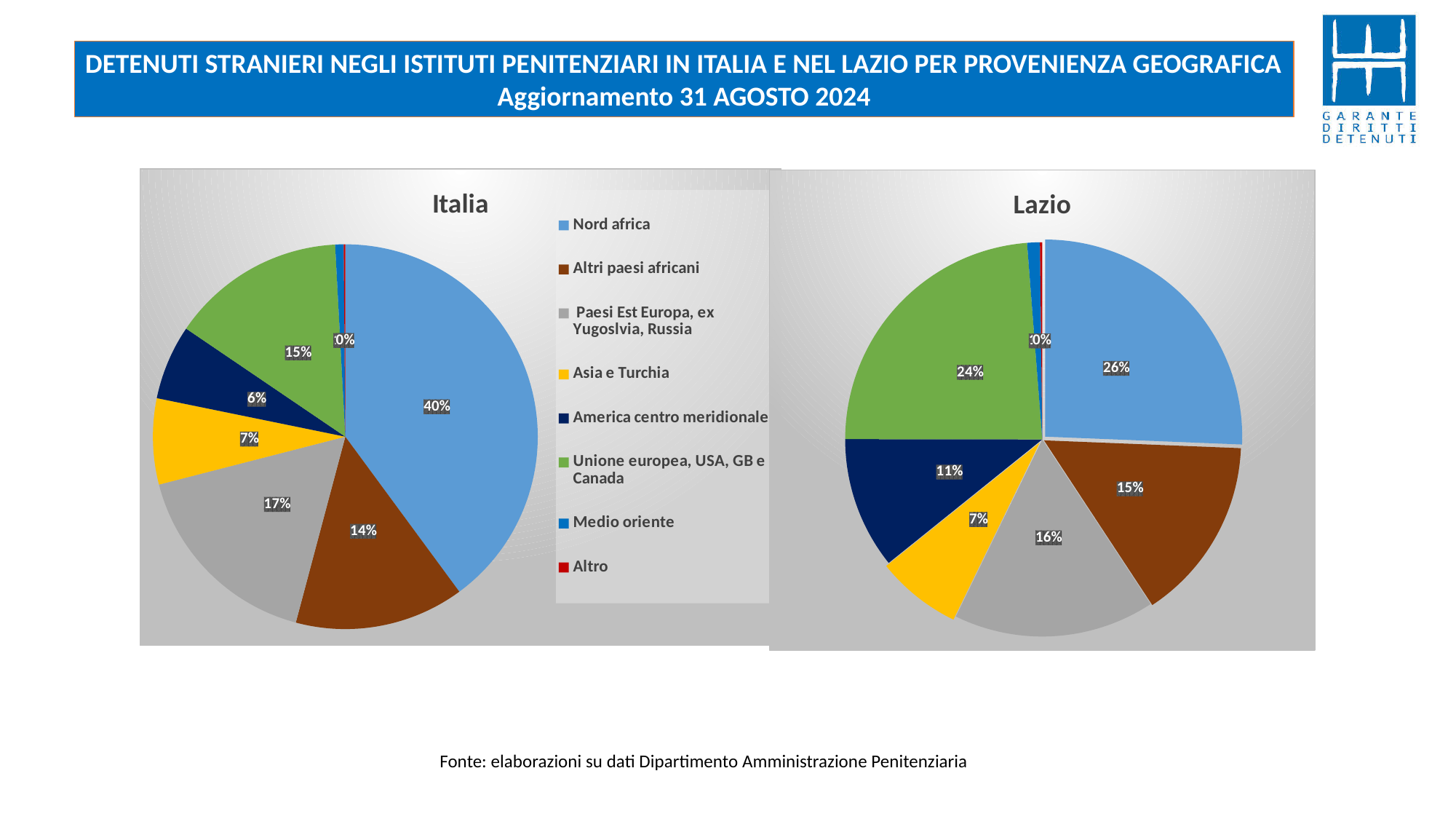
In the 'Italia' chart, what share is shown for Nord africa? 40% In the 'Lazio' chart, what share is shown for America centro meridionale? 11% What is the difference between the Nord africa share in the 'Italia' chart and in the 'Lazio' chart? 14 percentage points In the 'Lazio' chart, what share is shown for Unione europea, USA, GB e Canada? 24% Which colour represents Asia e Turchia in the legend? yellow What kind of chart is the 'Italia' chart? pie chart In the 'Italia' chart, what share is shown for Paesi Est Europa, ex Yugoslvia, Russia? 17% In the 'Italia' chart, which category has the largest slice? Nord africa In the 'Lazio' chart, what share is shown for Nord africa? 26% In the 'Italia' chart, what share is shown for America centro meridionale? 6% In the 'Lazio' chart, which is larger: Altri paesi africani or Unione europea, USA, GB e Canada? Unione europea, USA, GB e Canada How many categories does the legend list? 8